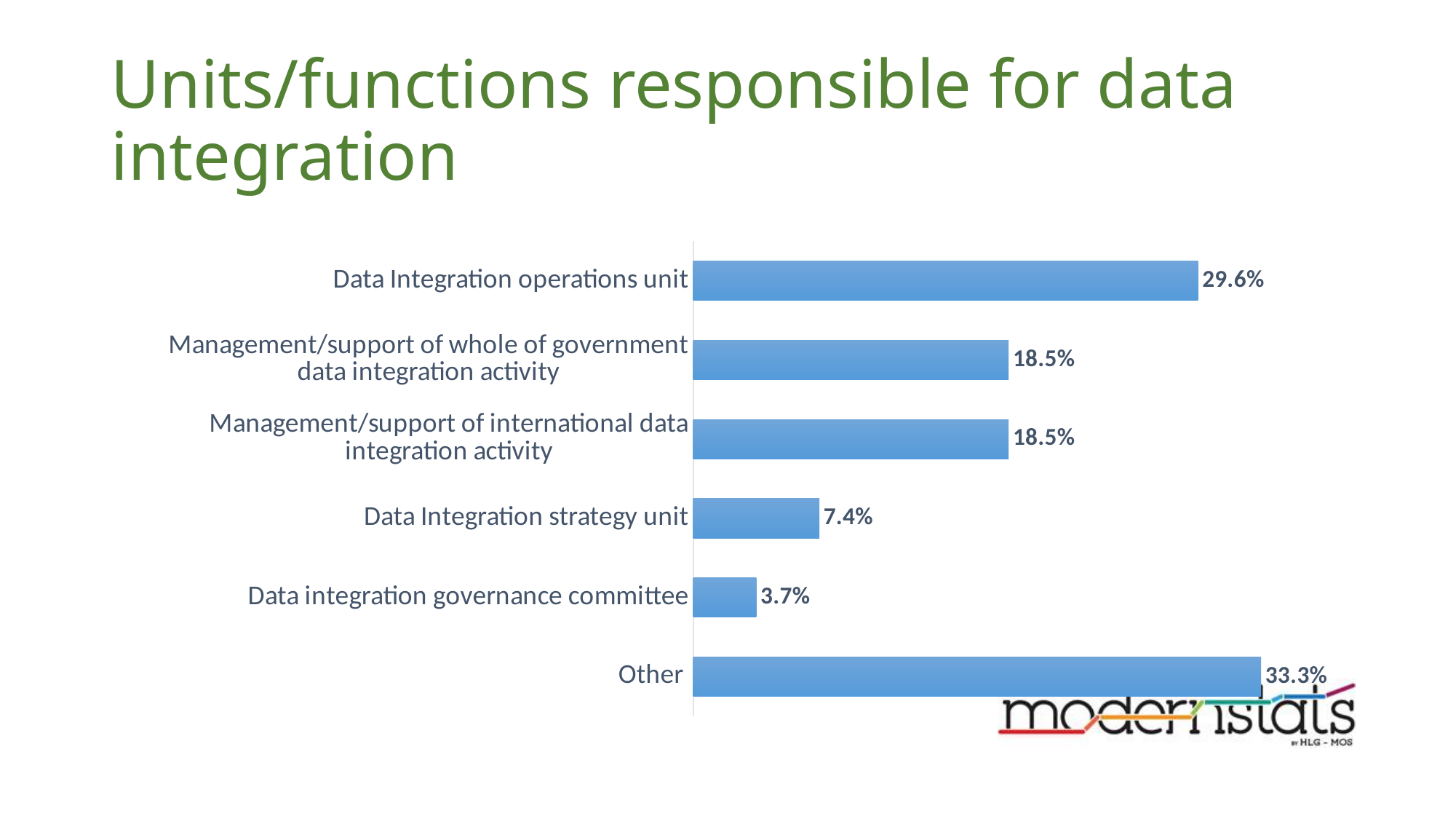
What is the value for Other? 33.3% Which category has the lowest value? Data integration governance committee Which category has the highest value? Other What is the value for Data Integration operations unit? 29.6% What kind of chart is shown on the slide? Bar chart What is the value for Data integration governance committee? 3.7% Which is larger, the value for Data Integration operations unit or the value for Management/support of whole of government data integration activity? Data Integration operations unit What is the value for Data Integration strategy unit? 7.4% What is the difference between the values for Other and Data Integration operations unit? 3.7% What is the value for Management/support of international data integration activity? 18.5% What is the difference between the values for Data Integration strategy unit and Data integration governance committee? 3.7% How many categories are shown in the chart? 6